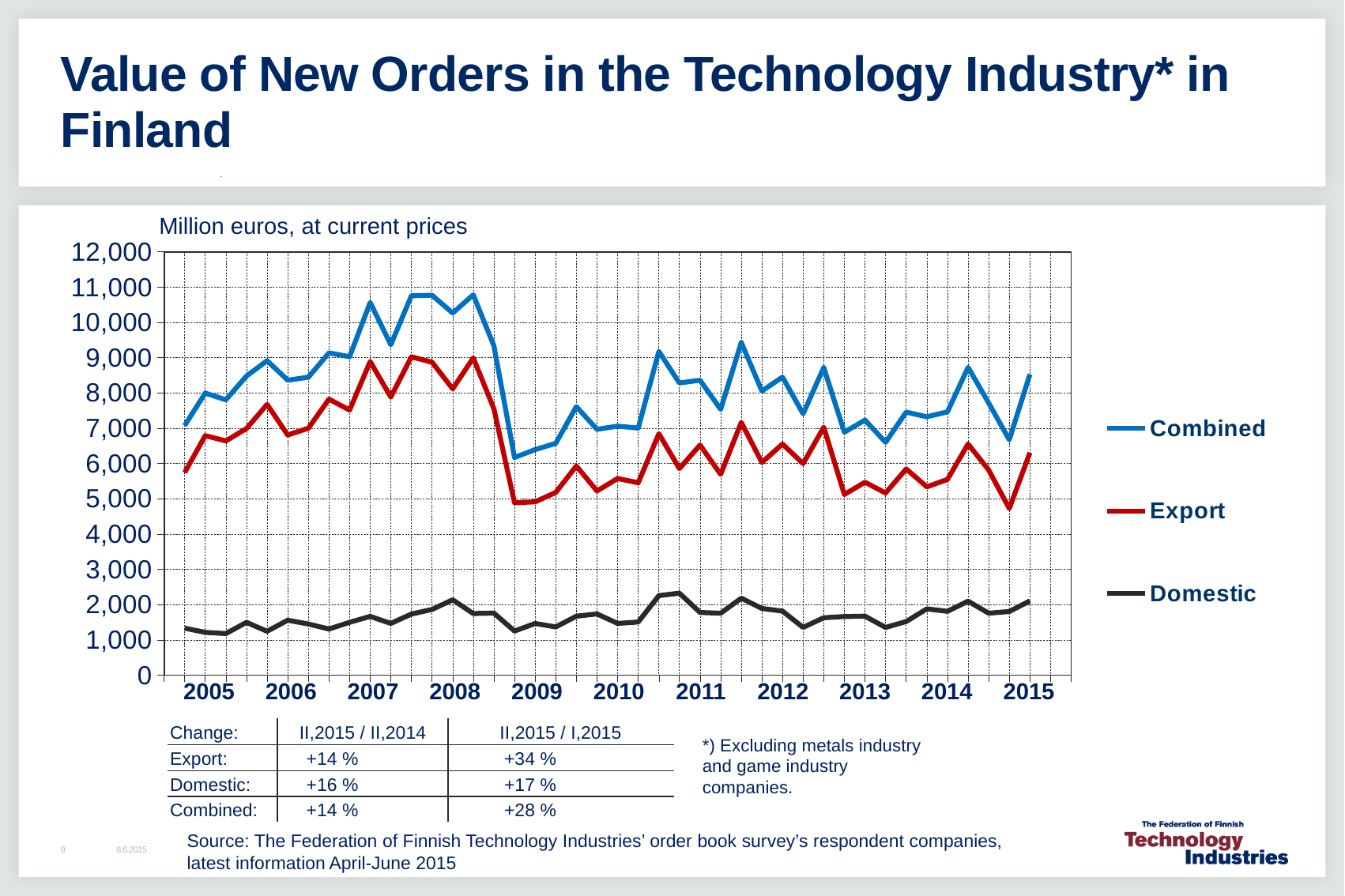
Does the Combined series rise or fall between 2008 and 2009? Fall Which is larger in 2011, the Export series or the Domestic series? Export Is the Domestic series ever greater or less than 3,000 across the whole period? less How many year labels are shown on the x axis? 11 How many series does the legend list? 3 Which series has the lowest values throughout the chart? Domestic Is the highest value of the Export series greater or less than 10,000? less Is the peak value of the Combined series in 2007–2008 greater or less than 10,000? greater What unit is stated above the chart? Million euros, at current prices Which series has the highest values throughout the chart? Combined What kind of chart is shown on the slide? Line chart